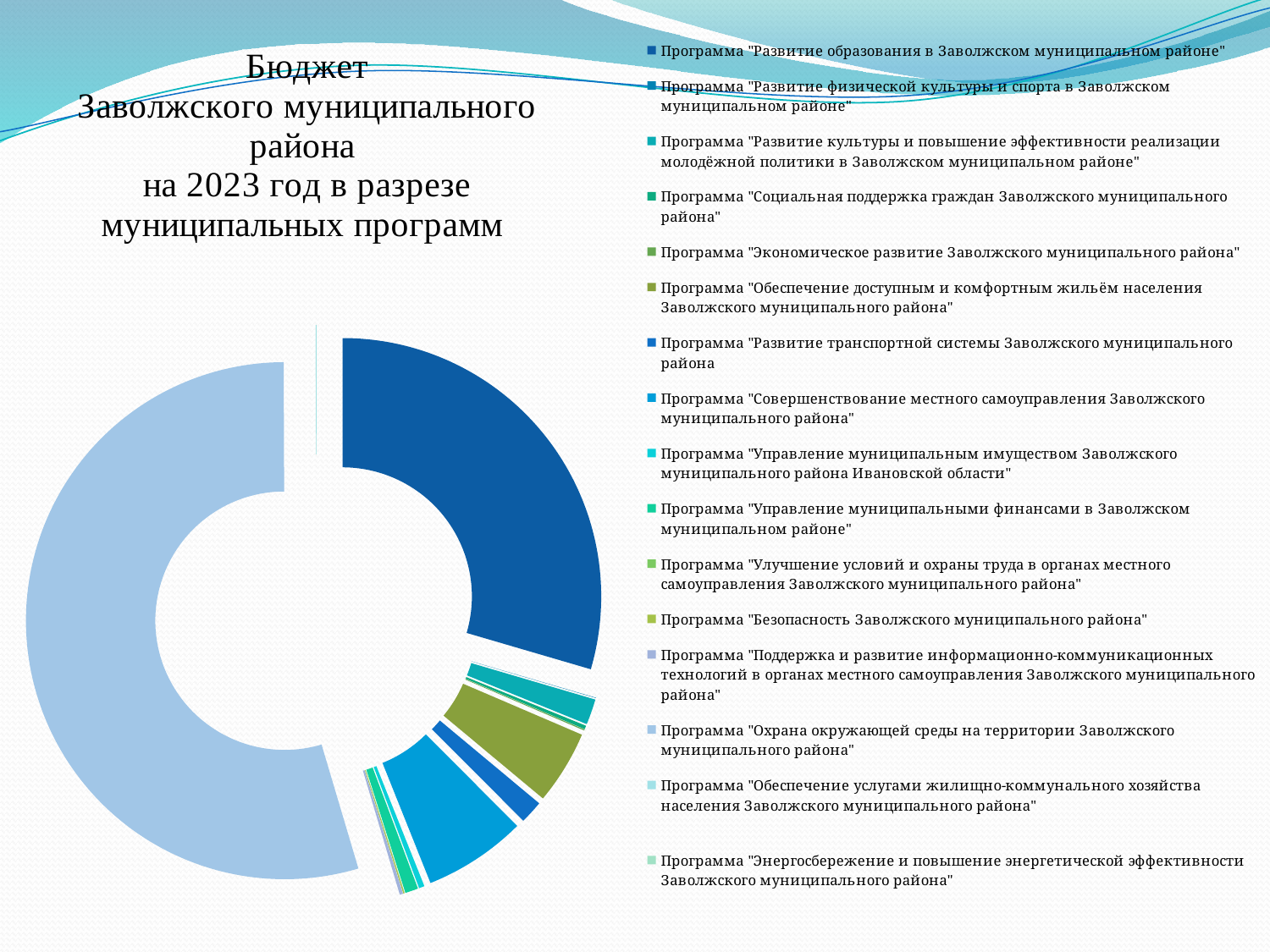
Is the share of the dark blue slice for Программа "Развитие образования в Заволжском муниципальном районе" greater or less than 10% of the doughnut? greater How many programmes (categories) does the legend of the chart list? 16 What is the title of the chart on the slide? Бюджет Заволжского муниципального района на 2023 год в разрезе муниципальных программ What kind of chart is shown on the slide? Doughnut (pie) chart Is the share of the dark blue slice for Программа "Развитие образования в Заволжском муниципальном районе" greater or less than 50% of the doughnut? less Which slice is larger: the dark blue slice for Программа "Развитие образования в Заволжском муниципальном районе" or the large light blue slice? the large light blue slice Which legend entry is listed first in the chart's legend? Программа "Развитие образования в Заволжском муниципальном районе"